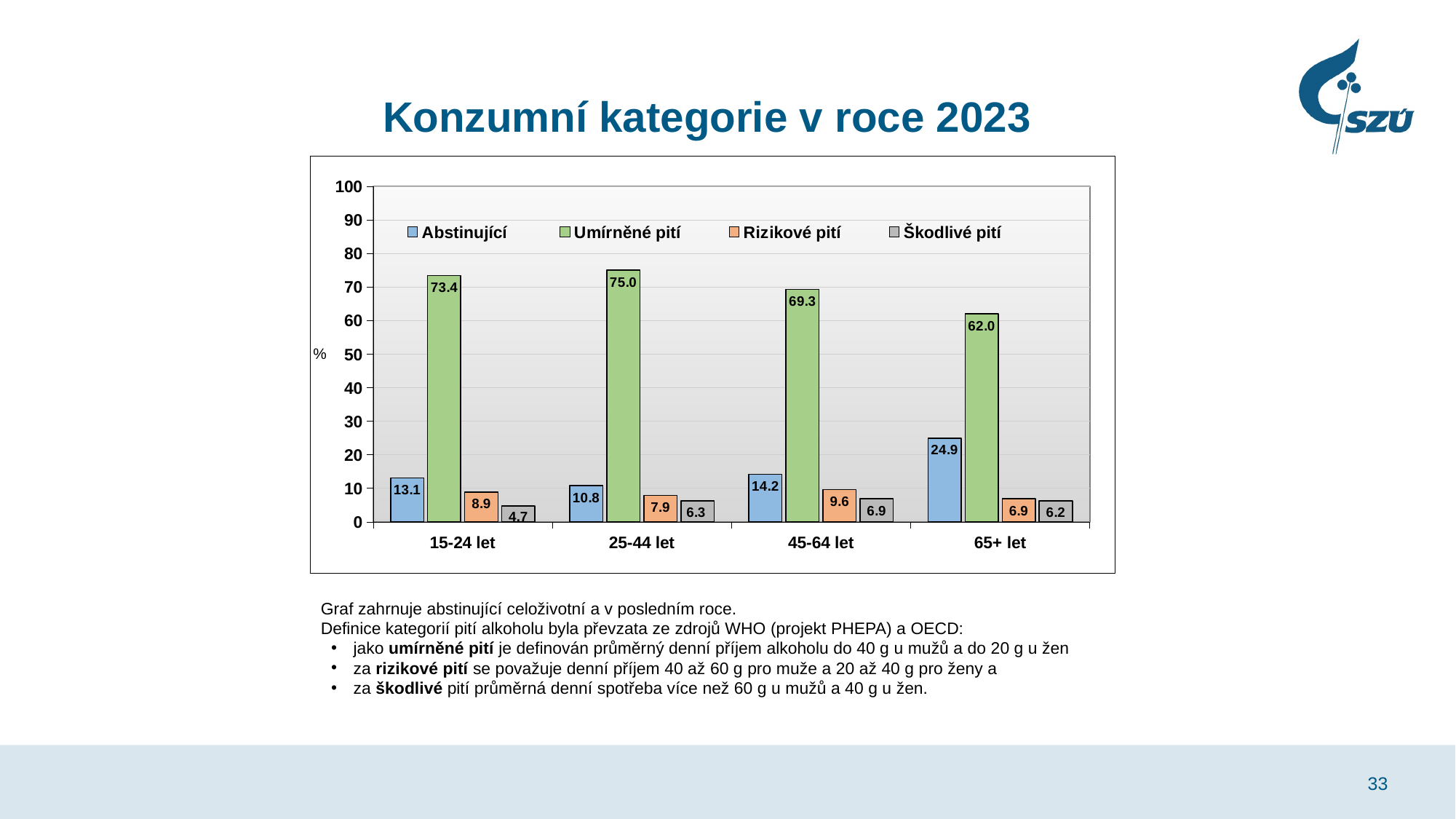
How many series does the legend list? 4 Is the value for Umírněné pití in the 45-64 let group greater or less than 60? greater What is the value for Umírněné pití in the 25-44 let age group? 75.0 What is the value for Škodlivé pití in the 15-24 let age group? 4.7 Which is larger: Rizikové pití for 45-64 let or Rizikové pití for 25-44 let? 45-64 let What is the difference between the Umírněné pití values for 25-44 let and 65+ let? 13.0 What is the title of the slide containing the chart? Konzumní kategorie v roce 2023 What is the value for Abstinující in the 65+ let age group? 24.9 Which age group has the lowest value for Umírněné pití? 65+ let Which age group has the highest value for Abstinující? 65+ let How many age groups are shown on the x axis? 4 What kind of chart is shown on the slide? bar chart